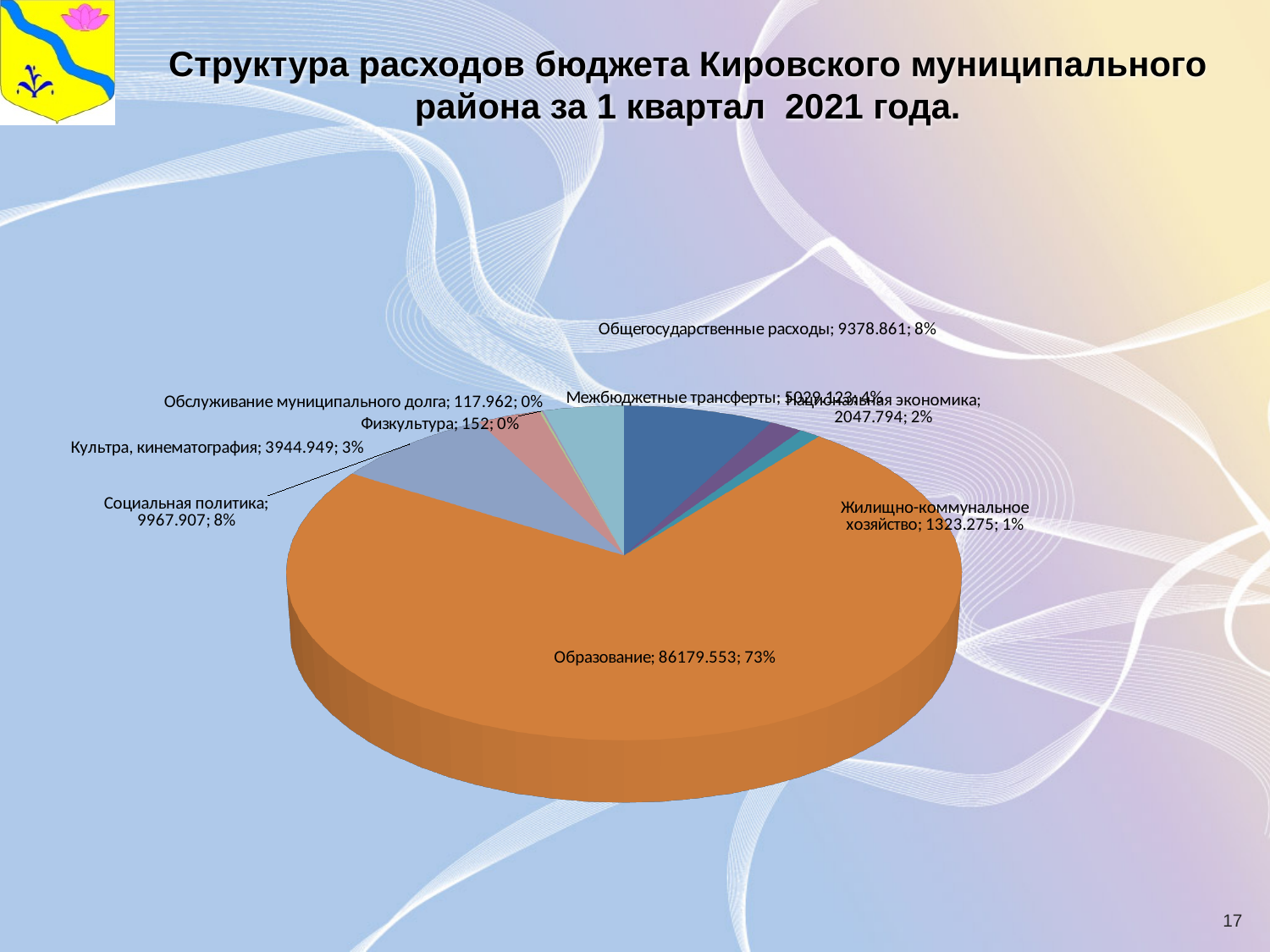
What is the value shown for Физкультура? 152 What is the difference between the values for Социальная политика and Общегосударственные расходы? 589.046 What share of the pie does Образование represent? 73% What is the value shown for Образование? 86179.553 What is the value shown for Социальная политика? 9967.907 How many categories are shown in the pie chart? 9 What kind of chart is shown on the slide? Pie chart Which category has the largest share of the pie? Образование What is the value shown for Жилищно-коммунальное хозяйство? 1323.275 Which category has the smallest value in the pie chart? Обслуживание муниципального долга Which is larger: the value for Национальная экономика or the value for Жилищно-коммунальное хозяйство? Национальная экономика What share of the pie does Культра, кинематография represent? 3%